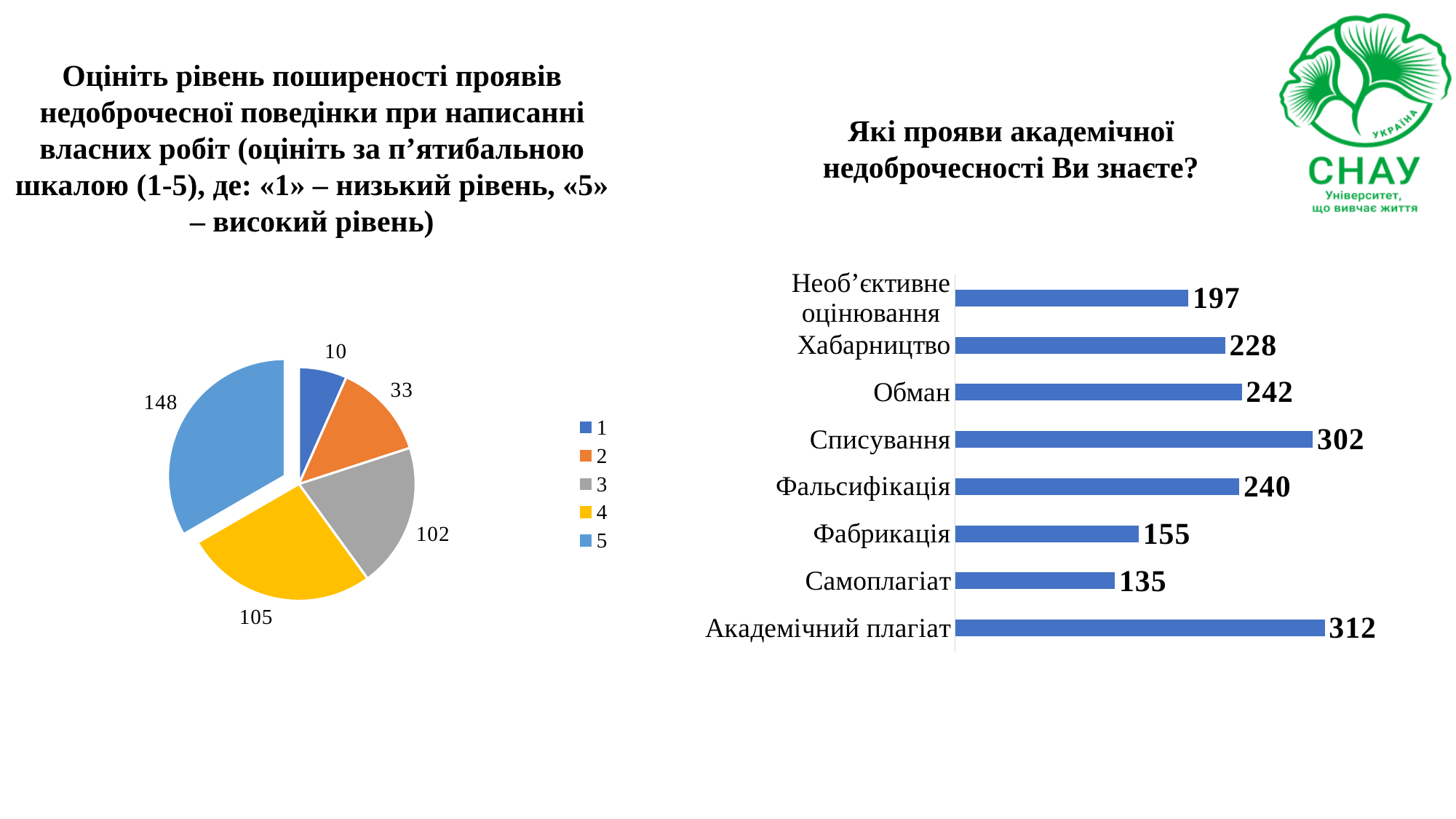
In the chart titled 'Які прояви академічної недоброчесності Ви знаєте?', which category has the highest value? Академічний плагіат In the pie chart on the left, how many entries does the legend list? 5 In the chart titled 'Які прояви академічної недоброчесності Ви знаєте?', how many categories are shown? 8 In the pie chart on the left, which category has the largest slice? 5 In the pie chart on the left, what is the value for category 5? 148 What kind of chart is the one on the right side of the slide? Bar chart In the pie chart on the left, what is the value for category 1? 10 In the chart titled 'Які прояви академічної недоброчесності Ви знаєте?', what is the value for Списування? 302 In the chart titled 'Які прояви академічної недоброчесності Ви знаєте?', what is the difference between Академічний плагіат and Списування? 10 In the pie chart on the left, what is the difference between the values for category 4 and category 3? 3 In the chart titled 'Які прояви академічної недоброчесності Ви знаєте?', which category has the lowest value? Самоплагіат In the pie chart on the left, which category has the smallest slice? 1